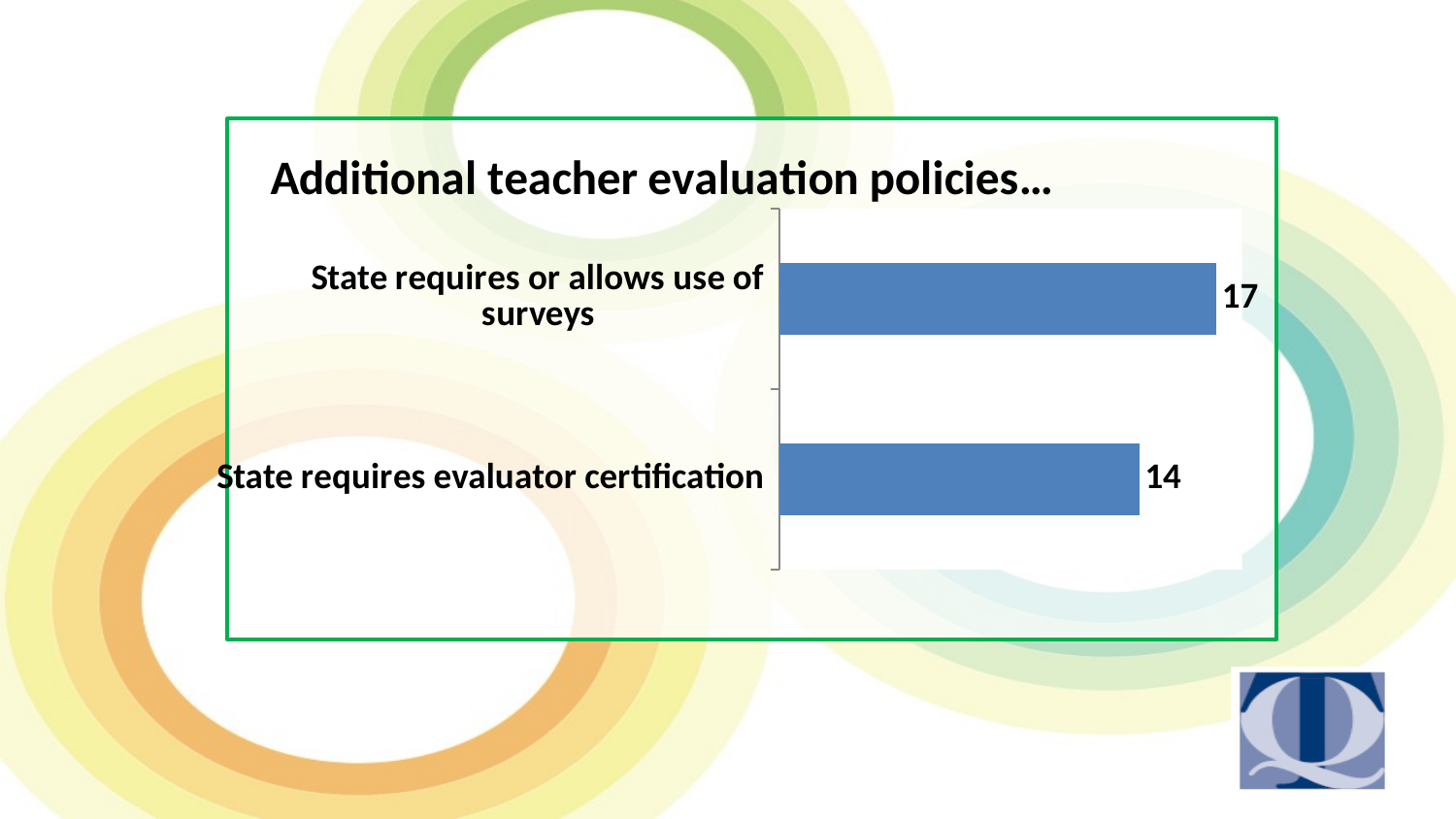
What is the value for 'State requires or allows use of surveys'? 17 Which category has the lowest value? State requires evaluator certification How many categories are shown in the chart? 2 What is the difference between the values for 'State requires or allows use of surveys' and 'State requires evaluator certification'? 3 What kind of chart is shown on the slide? Bar chart What is the value for 'State requires evaluator certification'? 14 What colour are the bars in the chart? Blue Which category has the highest value? State requires or allows use of surveys Which is larger: the value for 'State requires or allows use of surveys' or 'State requires evaluator certification'? State requires or allows use of surveys What is the title of the chart? Additional teacher evaluation policies…